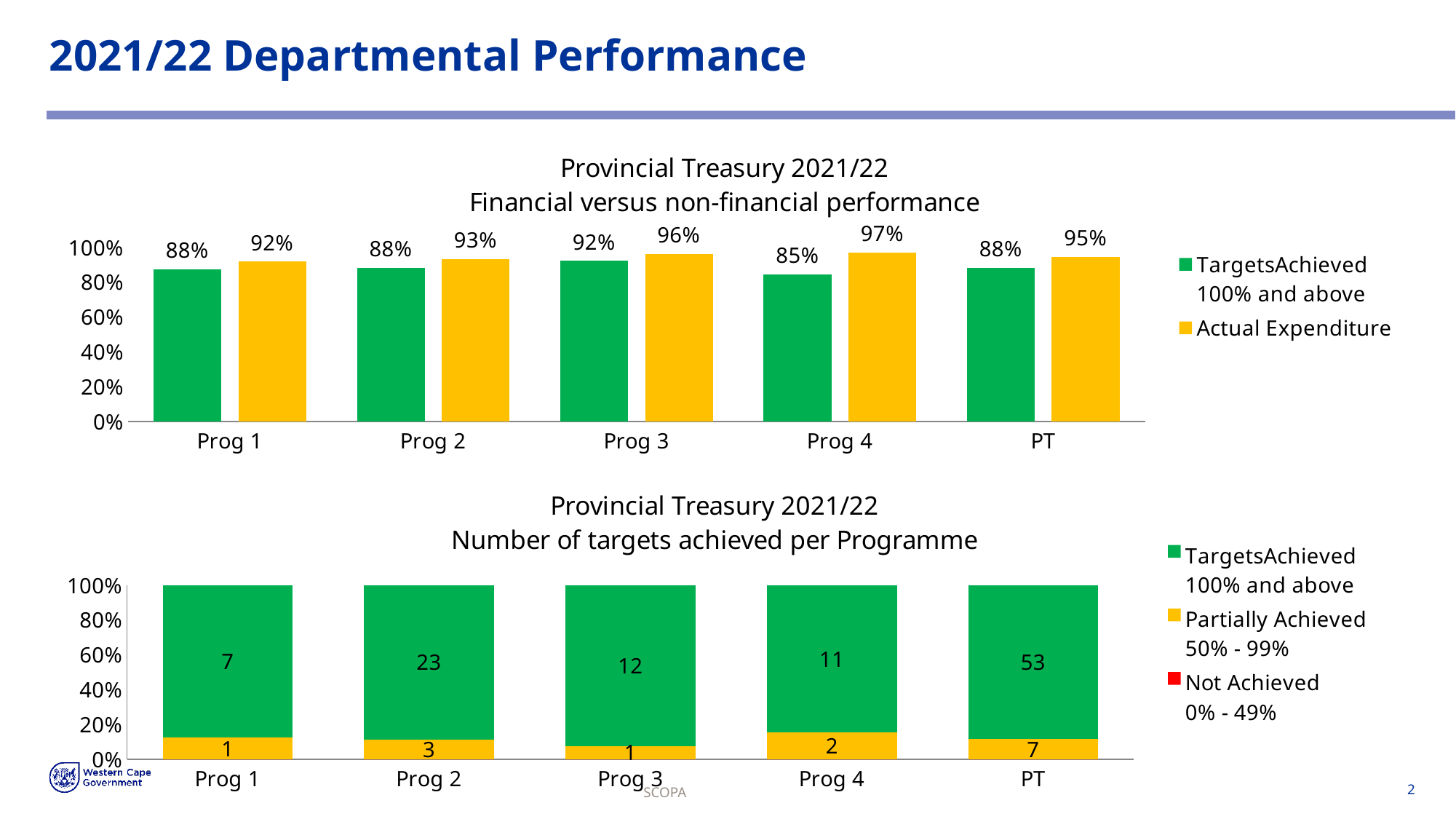
In the 'Financial versus non-financial performance' chart, how many series does the legend list? 2 What type of chart is the 'Number of targets achieved per Programme' chart? Stacked bar chart In the 'Financial versus non-financial performance' chart, what is the Targets Achieved value for Prog 4? 85% In the 'Number of targets achieved per Programme' chart, how many series does the legend list? 3 In the 'Financial versus non-financial performance' chart, which programme has the lowest Targets Achieved value? Prog 4 In the 'Number of targets achieved per Programme' chart, which programme has the most targets achieved (100% and above)? PT In the 'Financial versus non-financial performance' chart, which programme has the highest Actual Expenditure? Prog 4 In the 'Financial versus non-financial performance' chart, what is the Actual Expenditure value for Prog 3? 96% In the 'Number of targets achieved per Programme' chart, what is the total of the labelled values in the Prog 2 bar? 26 In the 'Number of targets achieved per Programme' chart, how many targets were achieved (100% and above) for Prog 2? 23 In the 'Number of targets achieved per Programme' chart, how many targets were partially achieved for PT? 7 In the 'Financial versus non-financial performance' chart, what is the difference between Actual Expenditure and Targets Achieved for Prog 4? 12%